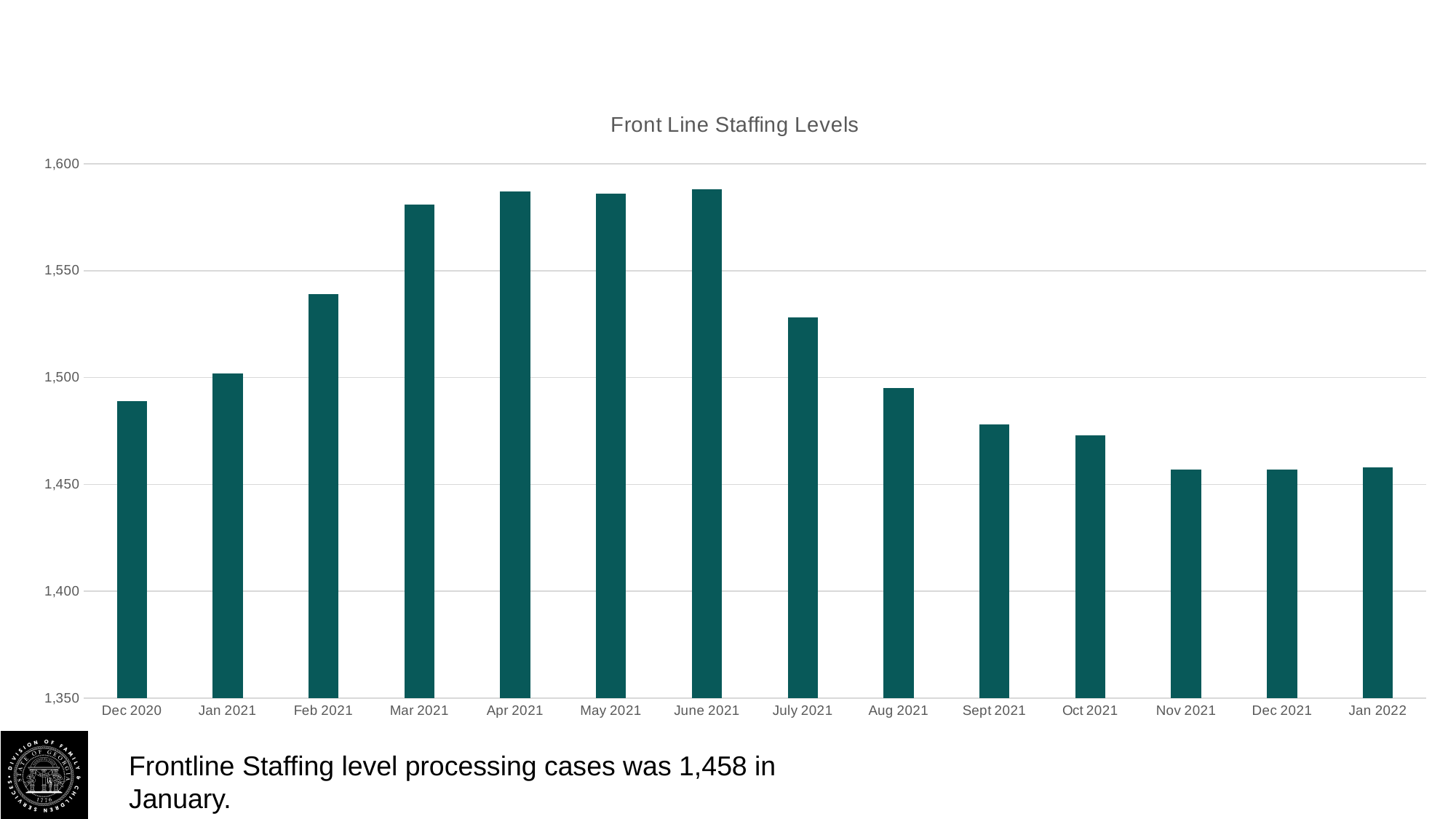
From June 2021 to Nov 2021, do the values rise or fall? fall What was the front line staffing level in Jan 2022? 1,458 Is the value for Sept 2021 greater or less than 1,500? less Is the value for July 2021 greater or less than 1,500? greater Is the value for Mar 2021 greater or less than 1,550? greater Which is larger, the value for July 2021 or the value for Aug 2021? July 2021 How many months are shown on the x axis of the chart? 14 What is the title of the chart? Front Line Staffing Levels Which is larger, the value for Mar 2021 or the value for Feb 2021? Mar 2021 What kind of chart is shown on the slide? bar chart